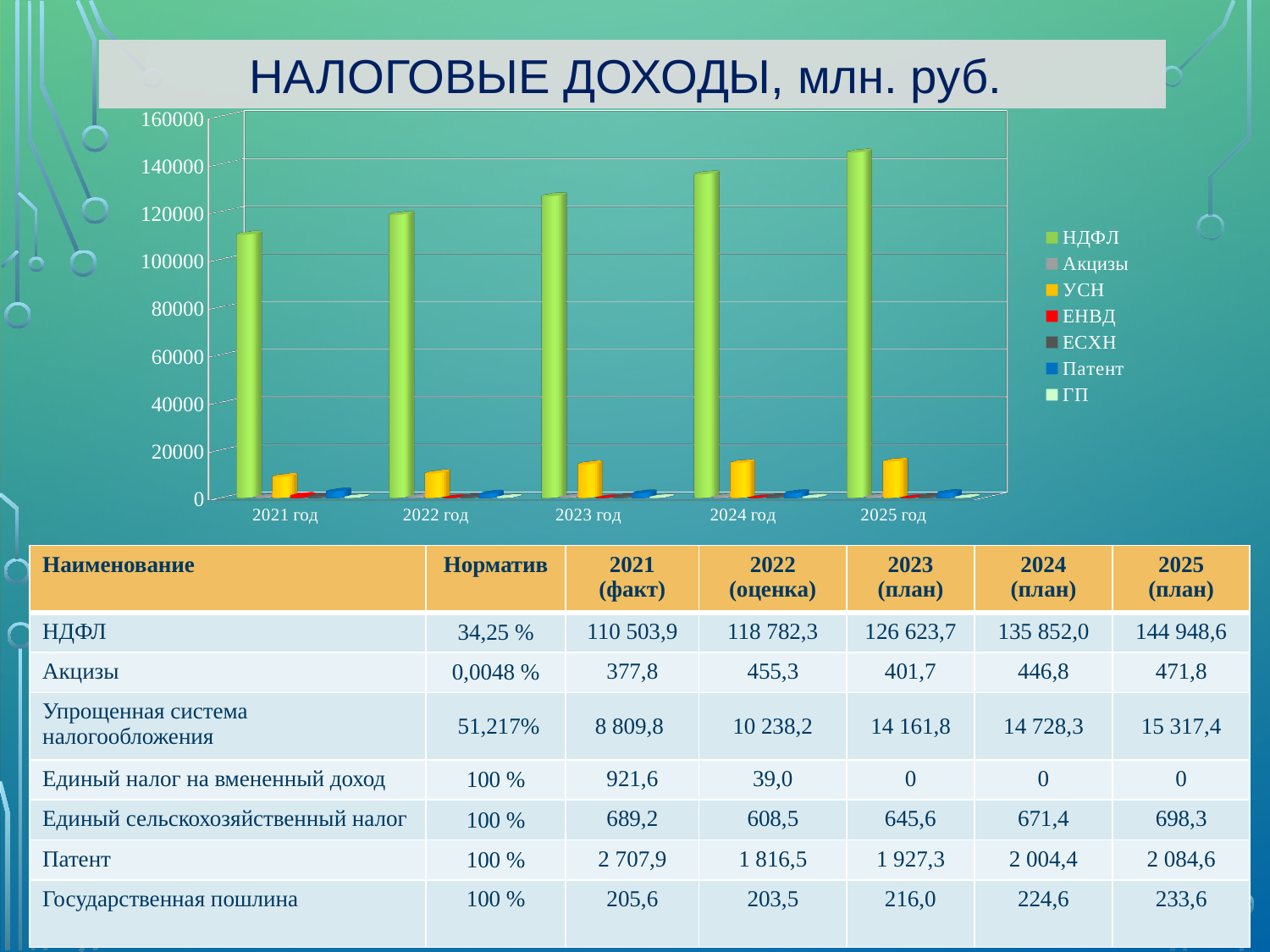
Which is larger, the УСН bar for 2025 год or for 2021 год? 2025 год What kind of chart is shown on the slide? bar chart In which year is the НДФЛ bar the highest? 2025 год Do the НДФЛ values rise or fall from 2021 год to 2025 год? rise Is the НДФЛ value for 2021 год greater or less than 120000? less Is the НДФЛ value for 2025 год greater or less than 140000? greater How many series does the chart legend list? 7 How many years are shown on the x axis of the chart? 5 What is the НДФЛ value for 2021 (факт) as printed in the table? 110 503,9 What is the difference between the НДФЛ values for 2025 (план) and 2021 (факт) as printed in the table? 34 444,7 In which year is the НДФЛ bar the lowest? 2021 год What is the title of the chart? НАЛОГОВЫЕ ДОХОДЫ, млн. руб.